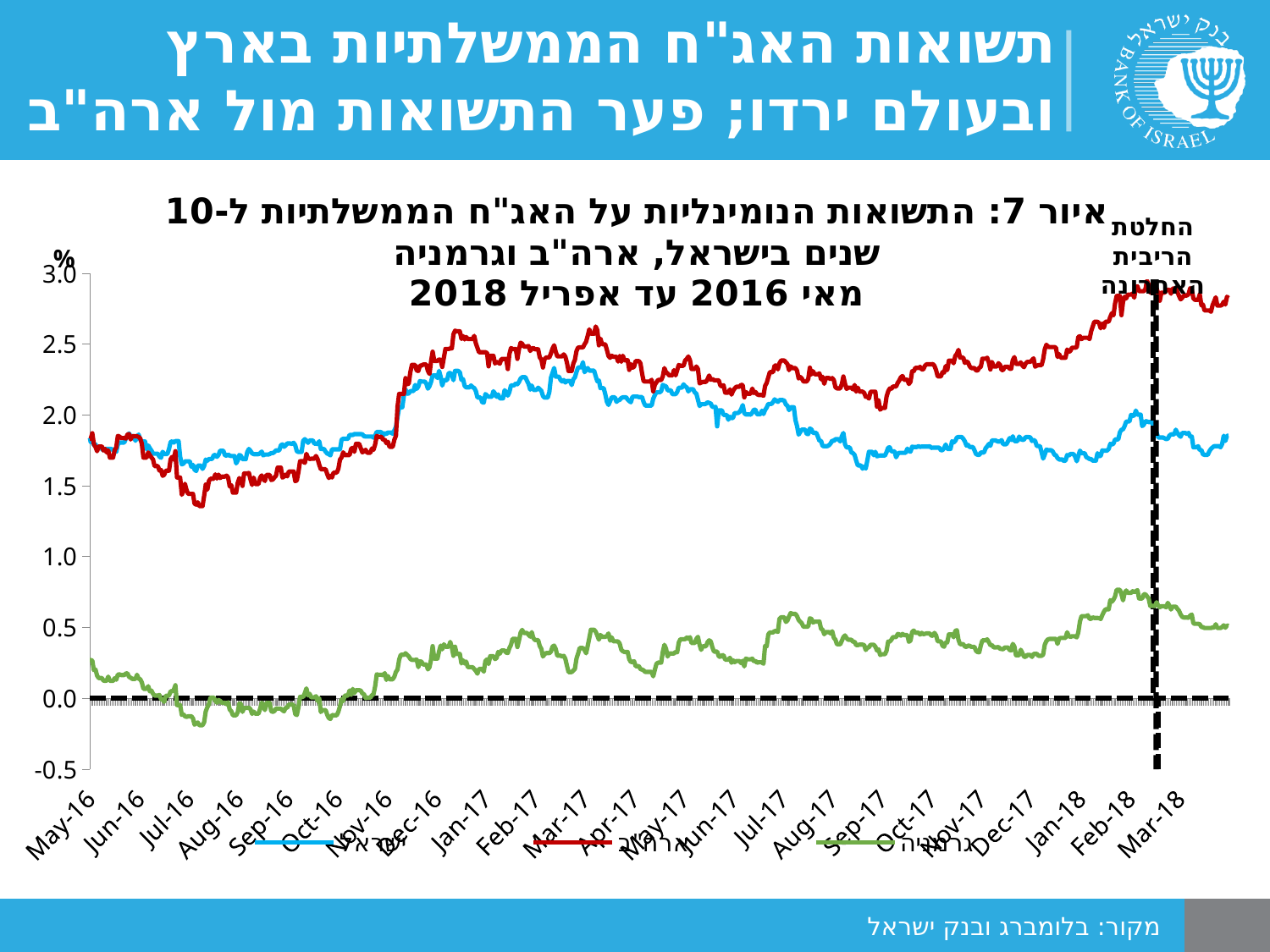
What type of chart is shown on the slide? line chart How many series does the legend list? 3 Does the ארה"ב (US) series rise or fall from Sep-17 to Feb-18? rise Is the value for ישראל (Israel) in Mar-18 greater or less than 2.0? less Which three countries' series are listed in the legend? ישראל, ארה"ב, גרמניה Which series has the lowest values across the whole period? גרמניה What unit is shown at the top of the y axis? % Is the value for גרמניה (Germany) in Feb-18 greater or less than 0.5? greater Is the value for גרמניה (Germany) in Jul-16 greater or less than 0.0? less At Mar-18, which series is higher, ארה"ב (US) or ישראל (Israel)? ארה"ב